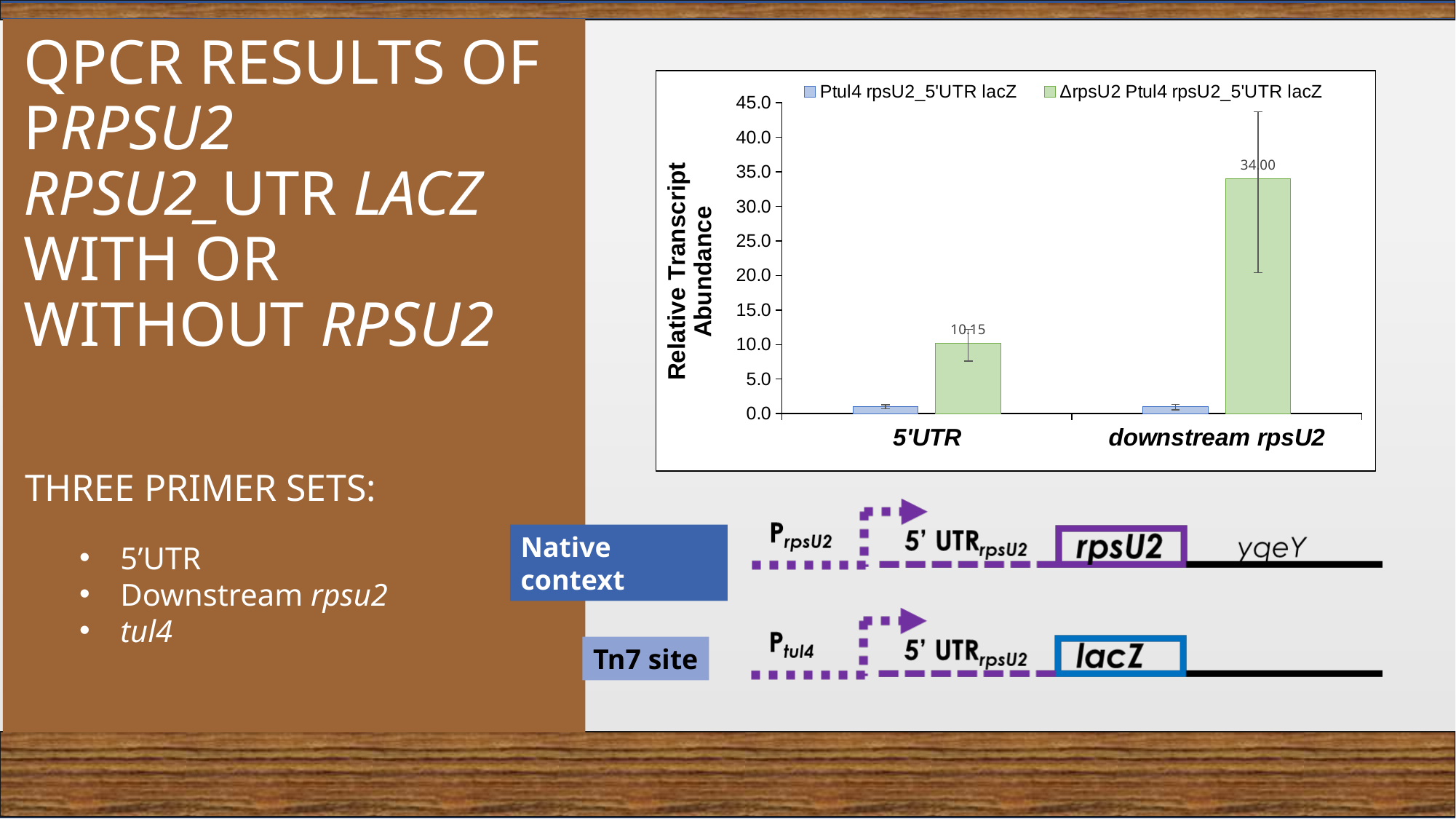
In the 5'UTR category, which series has the larger value: Ptul4 rpsU2_5'UTR lacZ or ΔrpsU2 Ptul4 rpsU2_5'UTR lacZ? ΔrpsU2 Ptul4 rpsU2_5'UTR lacZ What kind of chart is shown on the slide? Bar chart How many categories are shown on the x axis of the chart? 2 For the ΔrpsU2 Ptul4 rpsU2_5'UTR lacZ series, which category has the lowest value? 5'UTR What is the value of the ΔrpsU2 Ptul4 rpsU2_5'UTR lacZ series for the 5'UTR category? 10.15 What is the value of the ΔrpsU2 Ptul4 rpsU2_5'UTR lacZ series for the downstream rpsU2 category? 34.00 For the ΔrpsU2 Ptul4 rpsU2_5'UTR lacZ series, which category has the highest value? downstream rpsU2 What is the difference between the ΔrpsU2 Ptul4 rpsU2_5'UTR lacZ values for downstream rpsU2 and 5'UTR? 23.85 What is the title of the chart's y axis? Relative Transcript Abundance Is the value of the Ptul4 rpsU2_5'UTR lacZ series for downstream rpsU2 greater or less than 5.0? less How many series does the chart legend list? 2 Is the value of the ΔrpsU2 Ptul4 rpsU2_5'UTR lacZ series for downstream rpsU2 greater or less than 30.0? greater